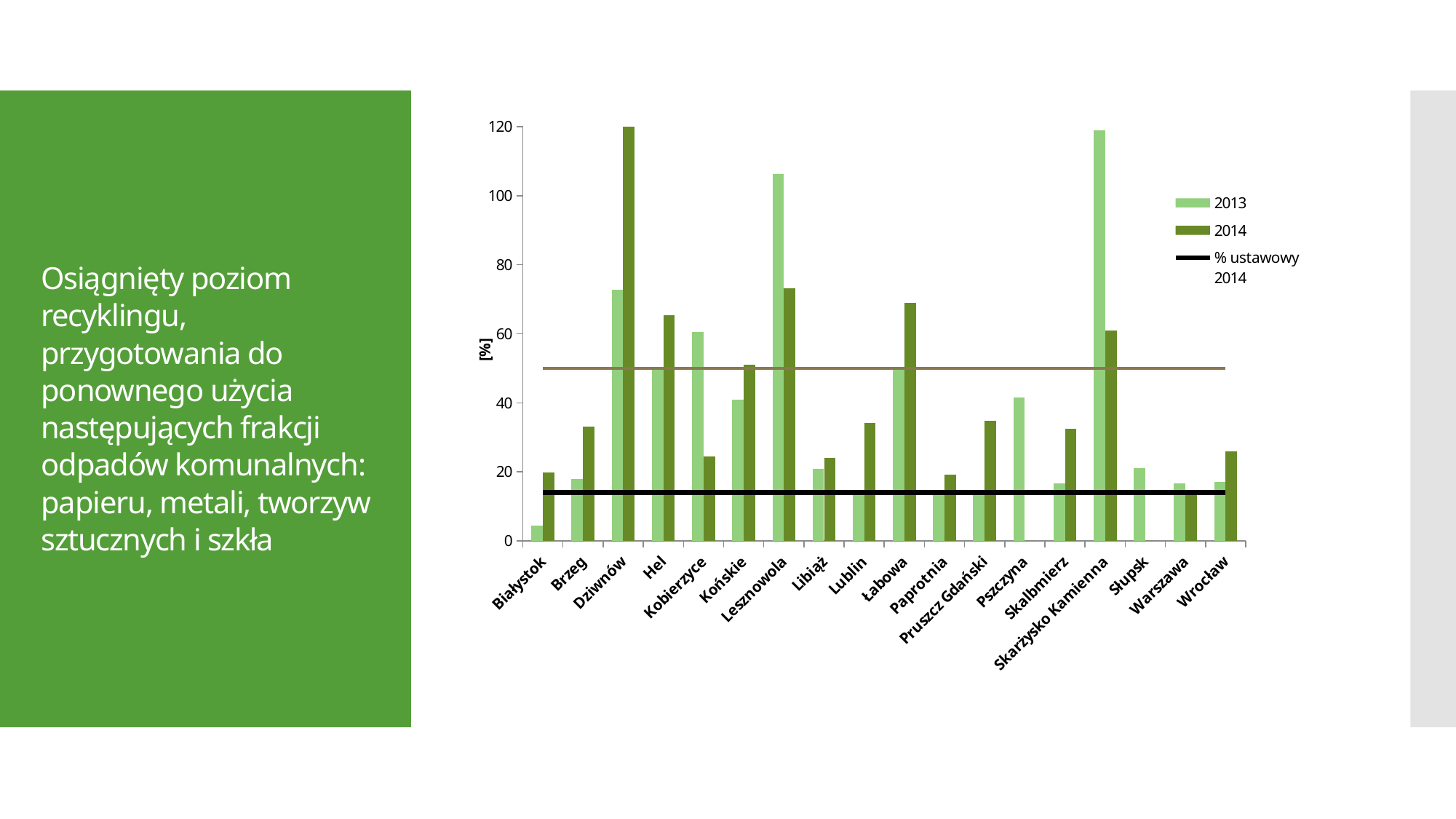
For Dziwnów, which is larger: the 2013 value or the 2014 value? 2014 How many municipalities are shown on the x axis? 18 Is the 2014 value for Hel greater or less than 60? greater What is the label on the vertical axis of the chart? [%] What kind of chart is shown on the slide? bar chart Is the 2013 value for Lesznowola greater or less than 100? greater Which municipality has the highest value for 2014? Dziwnów Is the 2013 value for Białystok greater or less than 20? less How many series does the legend list? 3 For Lesznowola, which is larger: the 2013 value or the 2014 value? 2013 Which municipality has the lowest value for 2013? Białystok Which municipality has the highest value for 2013? Skarżysko Kamienna